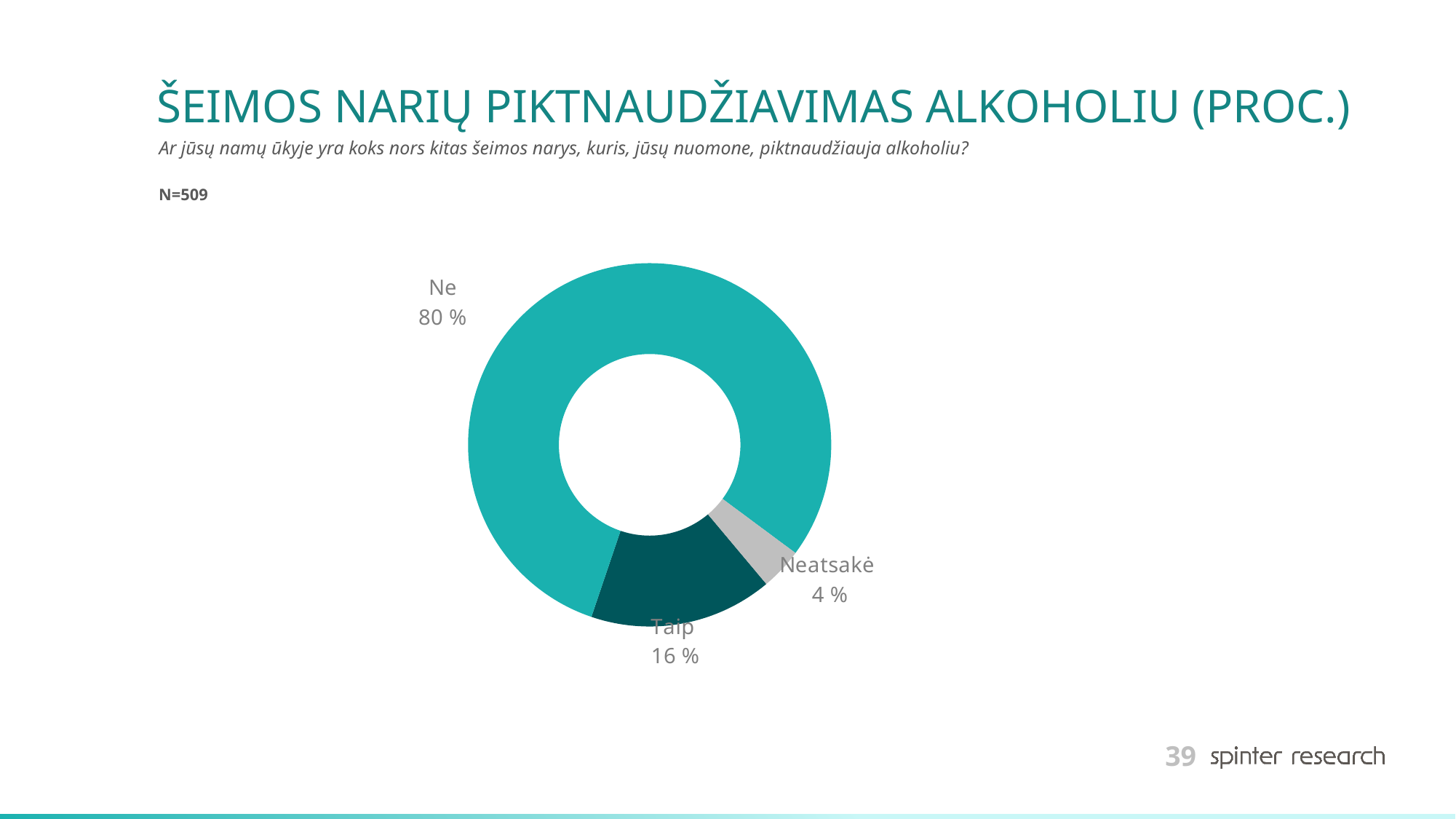
How many categories are shown in the chart? 3 What is the difference in percentage points between "Ne" and "Taip"? 64 What percentage of respondents answered "Neatsakė"? 4 % Which is larger, the share for "Taip" or the share for "Neatsakė"? Taip What percentage of respondents answered "Ne"? 80 % What kind of chart is shown on the slide? Doughnut (pie) chart What is the sample size (N) stated on the slide? N=509 Which category has the smallest share of the chart? Neatsakė Which category has the largest share of the chart? Ne What percentage of respondents answered "Taip"? 16 % What is the title of the slide? ŠEIMOS NARIŲ PIKTNAUDŽIAVIMAS ALKOHOLIU (PROC.) What is the difference in percentage points between "Taip" and "Neatsakė"? 12